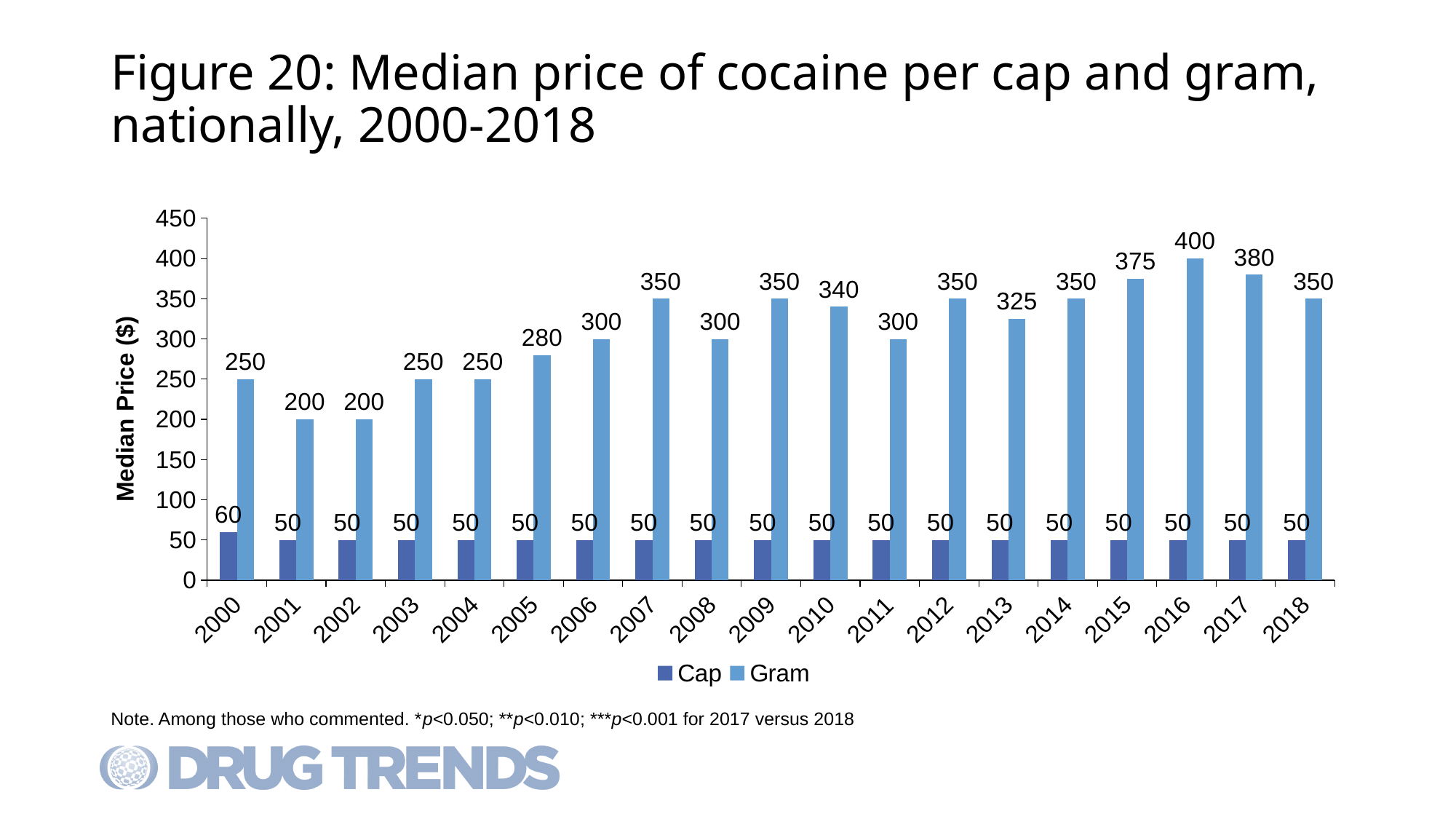
Which years have the lowest median price per gram? 2001 and 2002 What is the median price per cap in 2000? 60 In which year is the median price per gram highest? 2016 How many series does the legend list? 2 Which is larger, the median price per gram in 2010 or in 2012? 2012 How many years are shown on the x axis? 19 What is the median price per gram in 2016? 400 What is the median price per gram in 2013? 325 What is the difference between the median price per gram in 2017 and 2018? 30 What kind of chart is shown? Bar chart What is the label on the y axis? Median Price ($) Is the median price per gram in 2015 greater or less than 350? greater